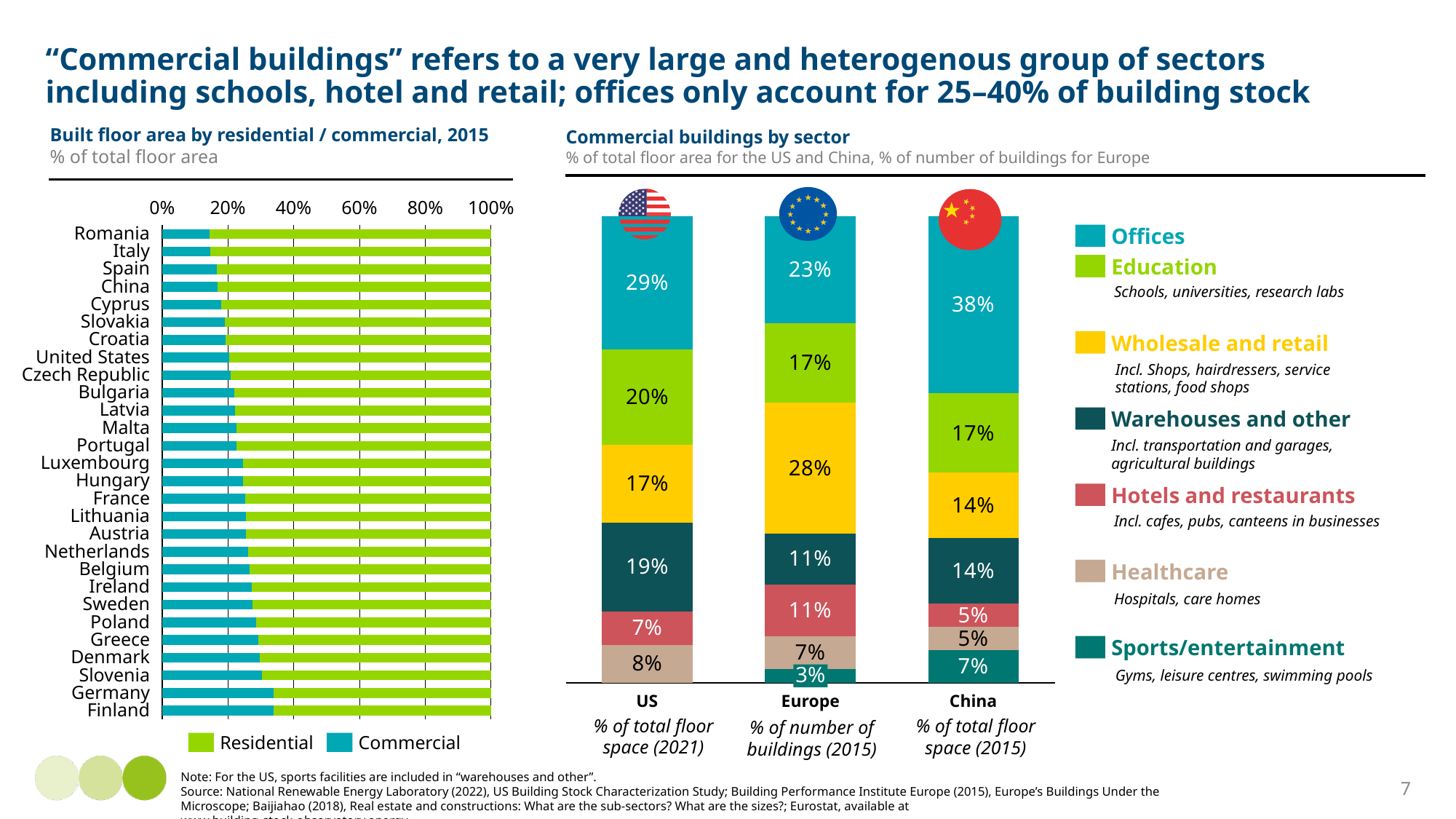
In the 'Built floor area by residential / commercial, 2015' chart, is the Commercial share for Finland greater or less than 20%? greater In the 'Built floor area by residential / commercial, 2015' chart, how many countries are listed? 28 In the 'Commercial buildings by sector' chart, how many regions are shown as bars? 3 In the 'Commercial buildings by sector' chart, what is the Warehouses and other value for the US? 19% In the 'Commercial buildings by sector' chart, what is the Wholesale and retail value for Europe? 28% What kind of chart is the 'Commercial buildings by sector' chart? Stacked bar chart In the 'Commercial buildings by sector' chart, which has the larger Education share, the US or Europe? US In the 'Commercial buildings by sector' chart, which region has the highest Offices share? China In the 'Commercial buildings by sector' chart, what share of China's commercial floor space is Offices? 38% In the 'Commercial buildings by sector' chart, how many percentage points higher is the Offices share for the US than for Europe? 6 percentage points In the 'Commercial buildings by sector' chart, how many sectors does the legend list? 7 In the 'Built floor area by residential / commercial, 2015' chart, how many series does the legend list? 2